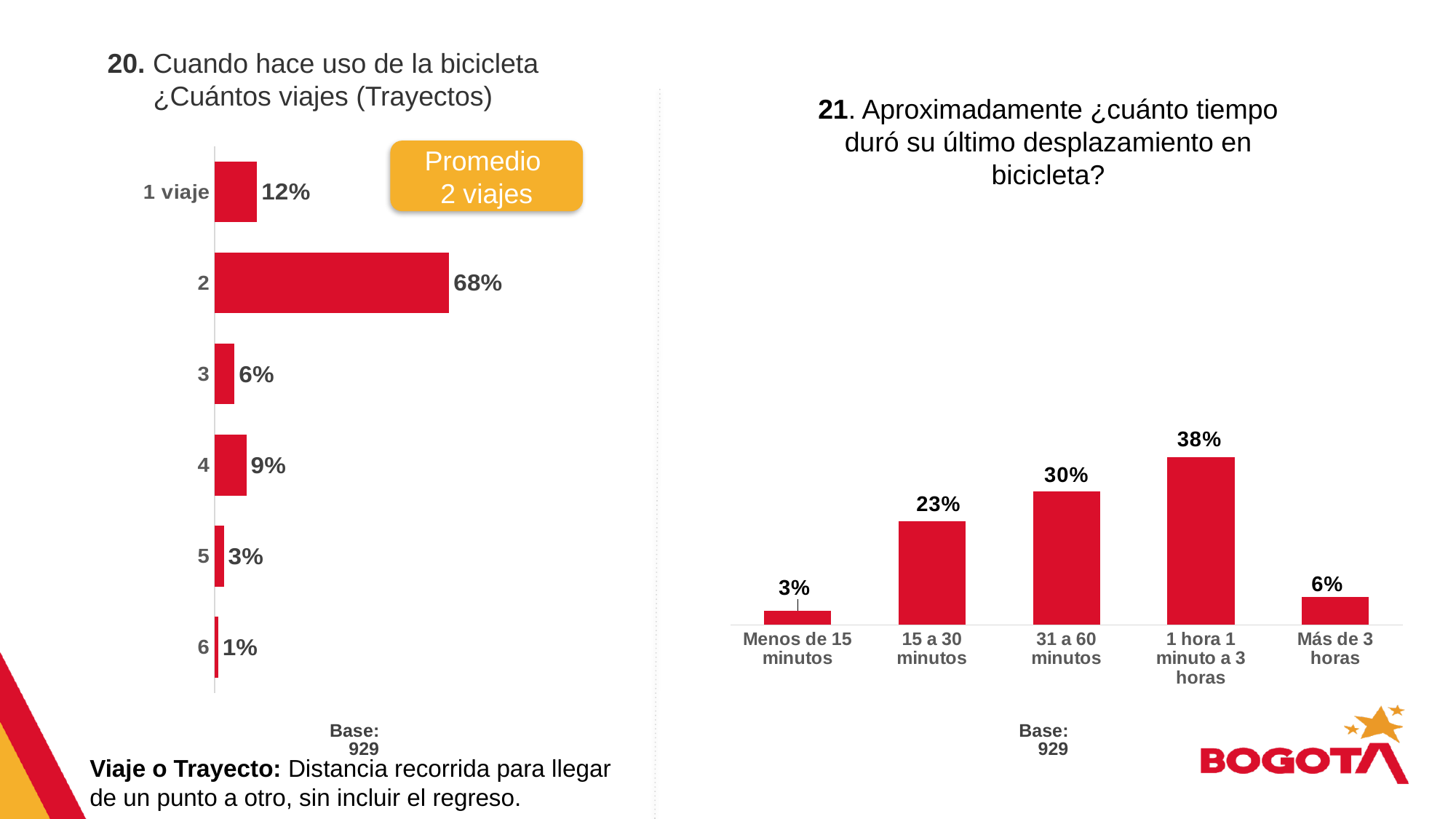
In the right chart (question 21, duration of last trip), what percentage corresponds to '31 a 60 minutos'? 30% In the left chart (question 20), how many categories are shown? 6 In the right chart (question 21), which is larger: '15 a 30 minutos' or 'Más de 3 horas'? 15 a 30 minutos In the left chart (question 20), what average number of trips is shown in the yellow box? 2 viajes In the left chart (question 20), what is the difference between the percentages for 1 viaje and 4 trips? 3% In the right chart (question 21), what is the difference between '1 hora 1 minuto a 3 horas' and '15 a 30 minutos'? 15% What type of chart is the right chart (question 21)? Bar chart In the right chart (question 21), which category has the lowest percentage? Menos de 15 minutos In the right chart (question 21), which category has the highest percentage? 1 hora 1 minuto a 3 horas In the left chart (question 20), which number of trips has the lowest percentage? 6 In the right chart (question 21), how many categories are shown? 5 In the left chart (question 20, number of trips), what percentage corresponds to 2 trips? 68%